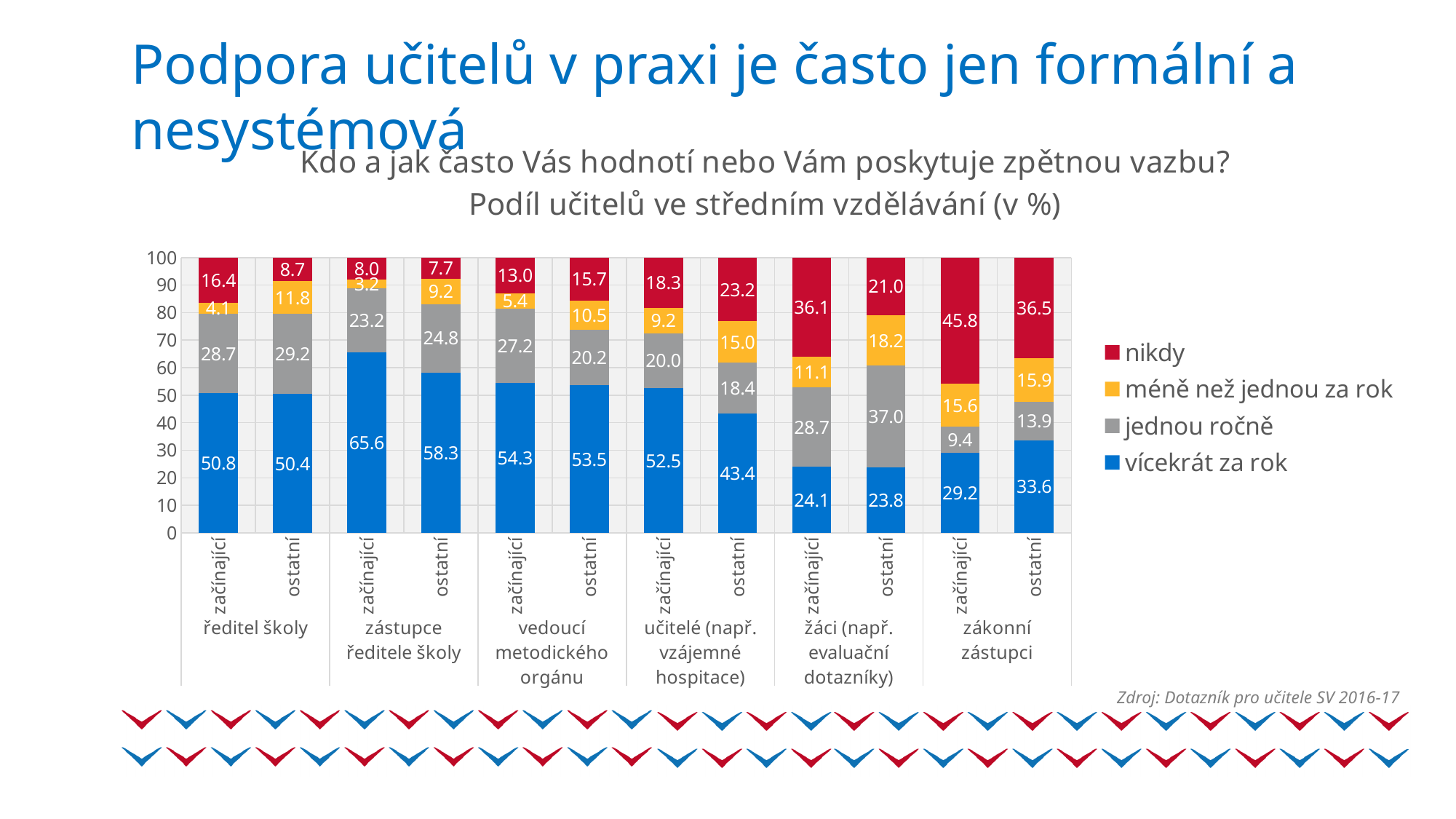
What is the value of 'vícekrát za rok' for začínající teachers in the 'zástupce ředitele školy' group? 65.6 What is the difference between the 'nikdy' values for začínající and ostatní teachers in the 'ředitel školy' group? 7.7 What is the value of 'jednou ročně' for ostatní teachers in the 'žáci (např. evaluační dotazníky)' group? 37.0 Which bar has the highest 'vícekrát za rok' value? zástupce ředitele školy – začínající What is the value of 'nikdy' for začínající teachers in the 'zákonní zástupci' group? 45.8 Which is larger: the 'nikdy' value for začínající teachers in the 'žáci' group or in the 'zákonní zástupci' group? zákonní zástupci How many bars are plotted in the chart? 12 What type of chart is shown on the slide? stacked bar chart Which bar has the lowest 'vícekrát za rok' value? žáci (např. evaluační dotazníky) – ostatní What is the value of 'méně než jednou za rok' for ostatní teachers in the 'ředitel školy' group? 11.8 How many series does the legend list? 4 Which series is shown in red in the legend? nikdy